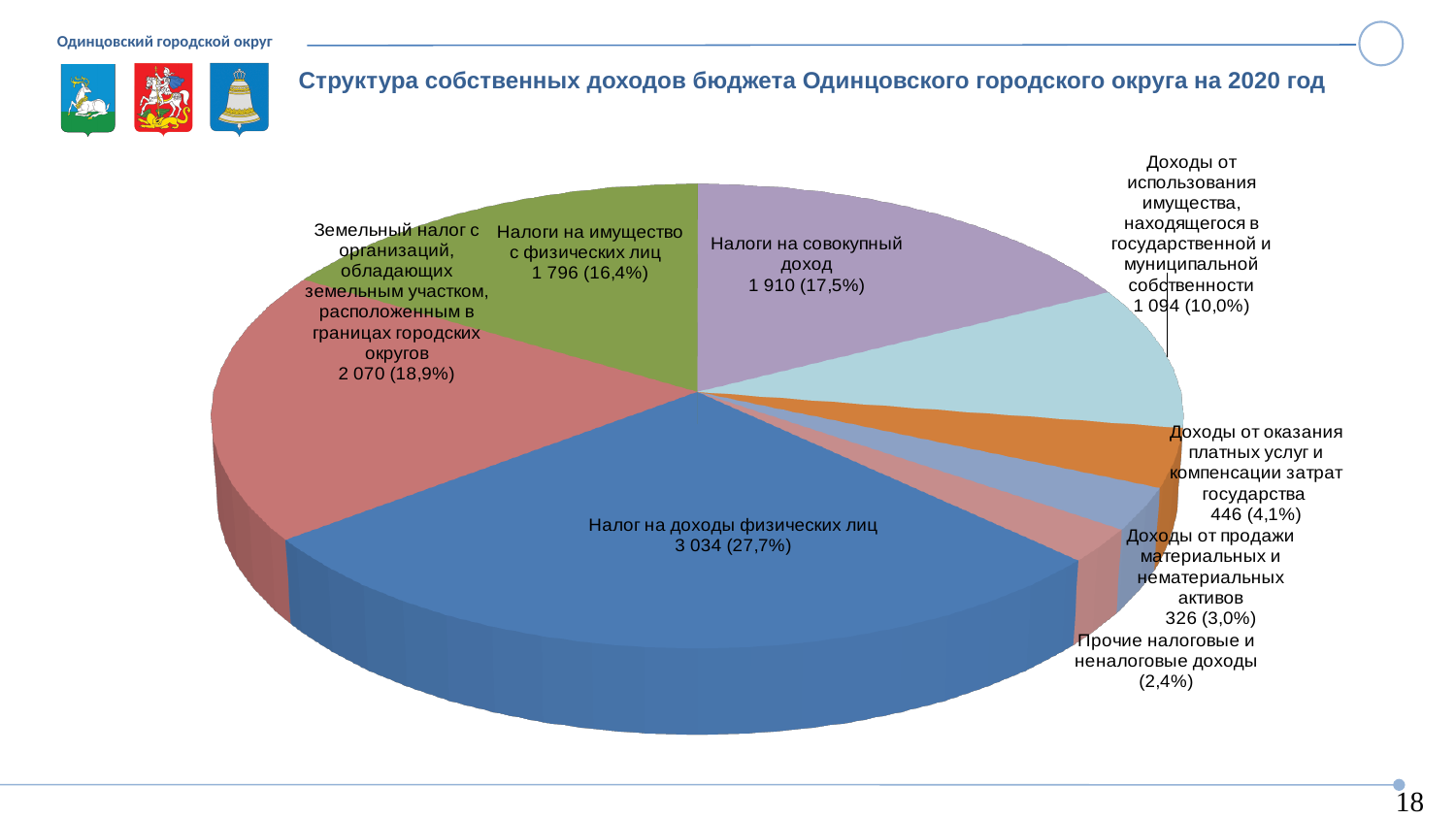
What is the value for "Доходы от оказания платных услуг и компенсации затрат государства"? 446 (4,1%) Which category has the smallest share of the pie? Прочие налоговые и неналоговые доходы How many slices does the pie chart have? 8 What share of the pie does "Доходы от продажи материальных и нематериальных активов" represent? 3,0% What share of the pie does "Земельный налог с организаций, обладающих земельным участком, расположенным в границах городских округов" represent? 18,9% Which category has the largest share of the pie? Налог на доходы физических лиц What is the value for "Налоги на совокупный доход"? 1 910 (17,5%) Which is larger: "Налоги на совокупный доход" or "Налоги на имущество с физических лиц"? Налоги на совокупный доход What kind of chart is shown on the slide? Pie chart What is the difference between the values for "Налог на доходы физических лиц" and "Земельный налог с организаций..."? 964 What is the value for "Налоги на имущество с физических лиц"? 1 796 (16,4%) What is the value for "Налог на доходы физических лиц"? 3 034 (27,7%)